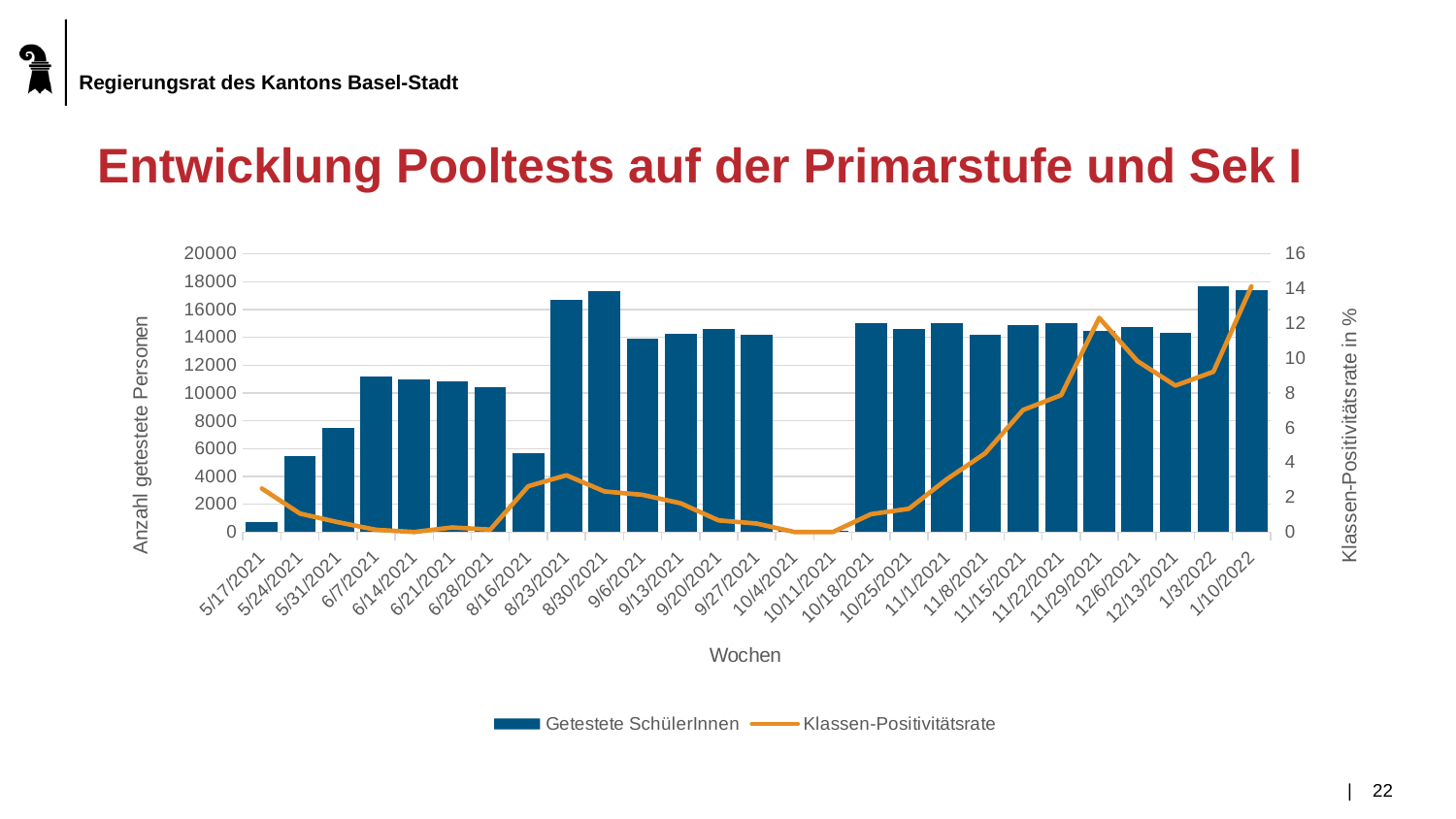
Which week has a higher Klassen-Positivitätsrate, 9/13/2021 or 11/22/2021? 11/22/2021 How many series does the legend list? 2 What is the label of the right-hand y axis? Klassen-Positivitätsrate in % How many weeks are shown on the x axis? 27 Is the number of Getestete SchülerInnen for 6/7/2021 greater or less than 10000? greater What kind of chart is shown on the slide? Combined bar and line chart Which week has the highest Klassen-Positivitätsrate? 1/10/2022 Is the Klassen-Positivitätsrate for 11/29/2021 greater or less than 10? greater Is the number of Getestete SchülerInnen for 5/24/2021 greater or less than 6000? less Which week has more Getestete SchülerInnen, 8/30/2021 or 9/6/2021? 8/30/2021 Does the Klassen-Positivitätsrate rise or fall overall from 10/11/2021 to 1/10/2022? rise